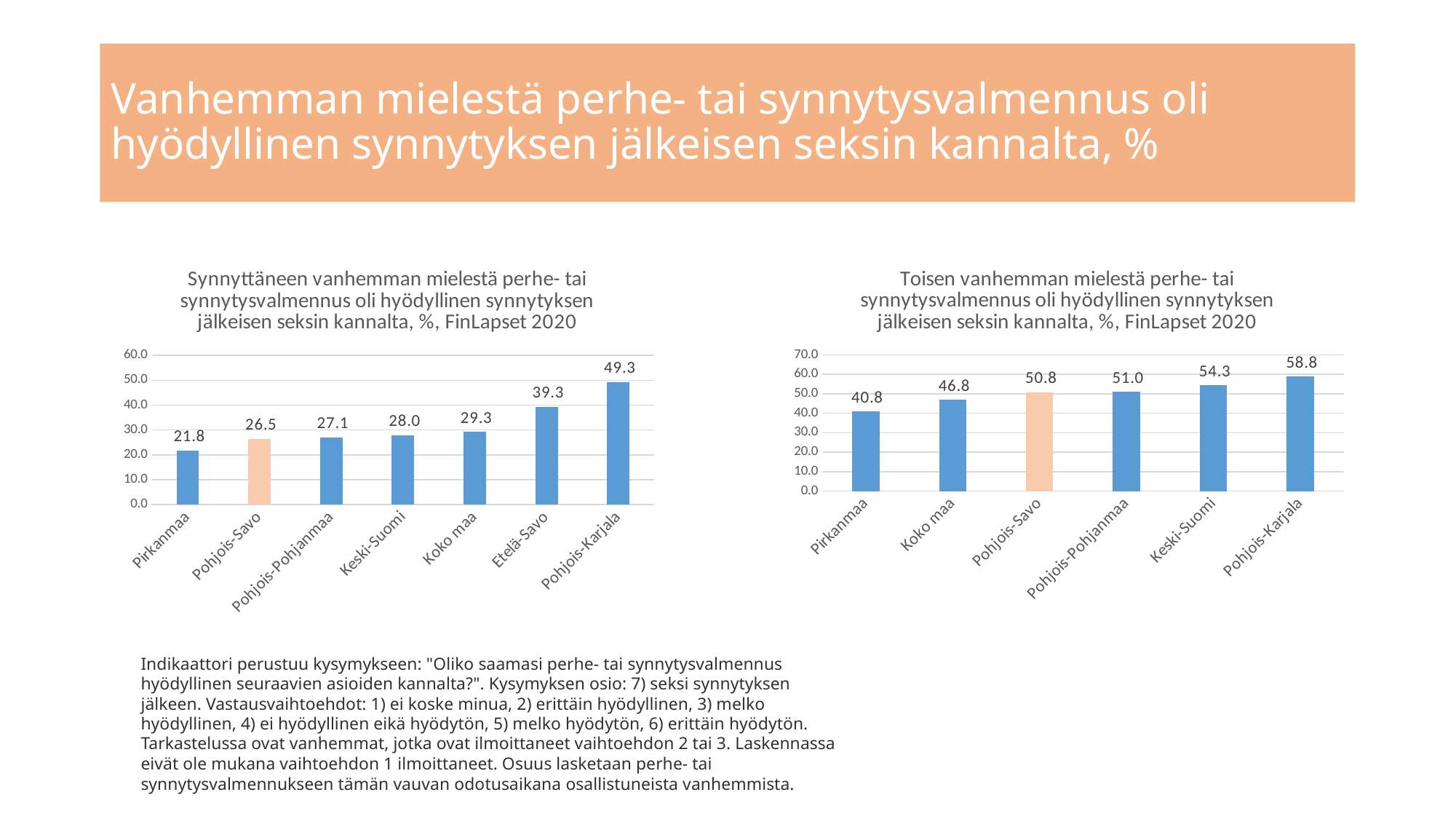
In the right chart, is the value for Pohjois-Pohjanmaa greater or less than 40.0? greater In the right chart, what is the difference between Pohjois-Karjala and Koko maa? 12.0 In the left chart (Synnyttäneen vanhemman mielestä...), what is the value for Pohjois-Savo? 26.5 In the right chart, which category has the lowest value? Pirkanmaa In the right chart (Toisen vanhemman mielestä...), what is the value for Keski-Suomi? 54.3 In the left chart, what is the difference between Pohjois-Karjala and Pirkanmaa? 27.5 In the left chart, which category has the highest value? Pohjois-Karjala How many categories are shown in the right chart? 6 How many categories are shown in the left chart? 7 What kind of chart is the right chart? bar chart In the left chart, which category's bar is coloured differently (orange) from the others? Pohjois-Savo In the left chart, which is larger: Etelä-Savo or Koko maa? Etelä-Savo